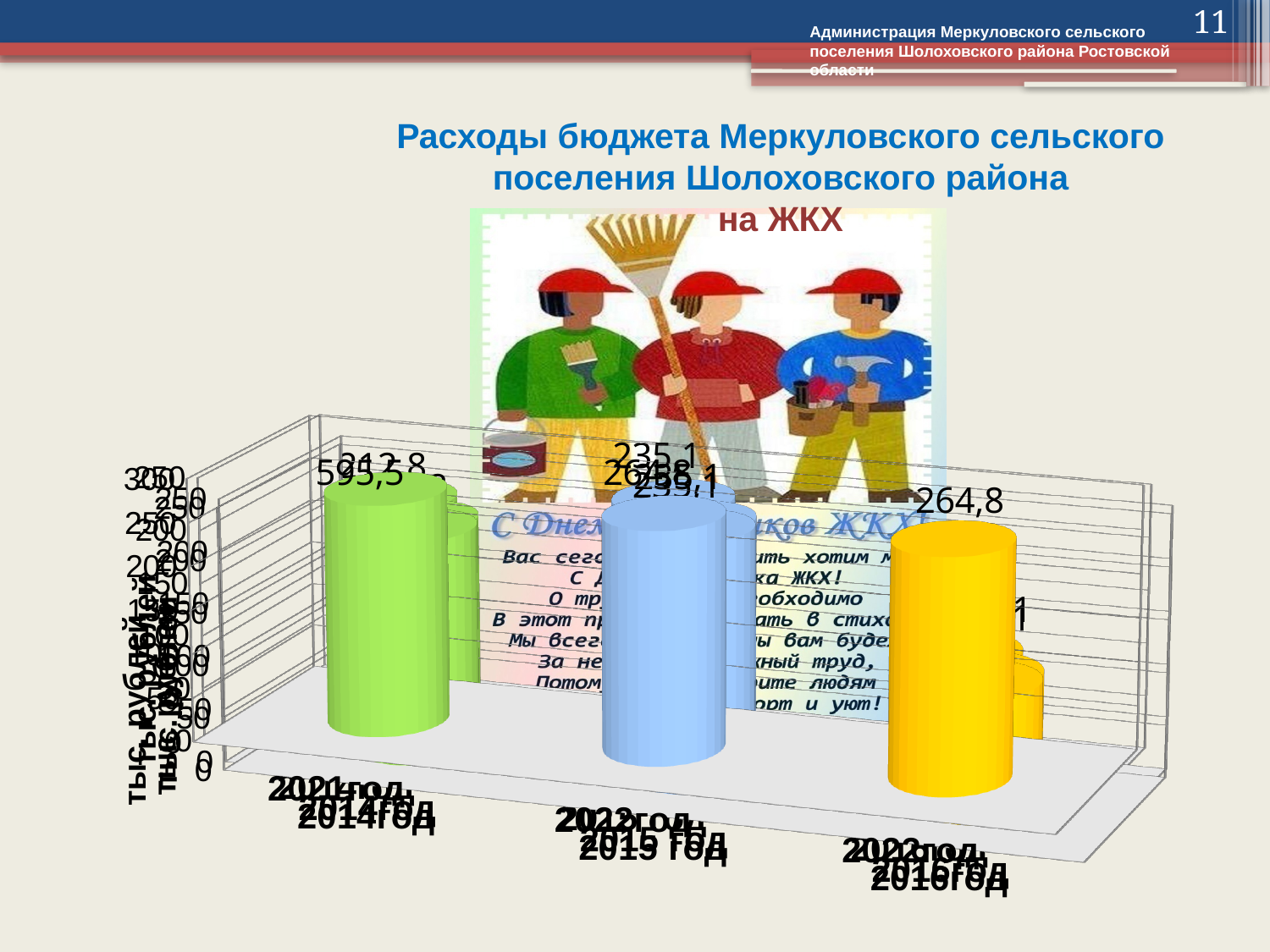
What is the title of the chart on the slide? Расходы бюджета Меркуловского сельского поселения Шолоховского района на ЖКХ How many bars are shown in the front chart on the slide? 3 What colour is the rightmost bar in the chart? yellow What kind of chart is shown on the slide? bar chart What value is labelled on the yellow bar in the chart? 264,8